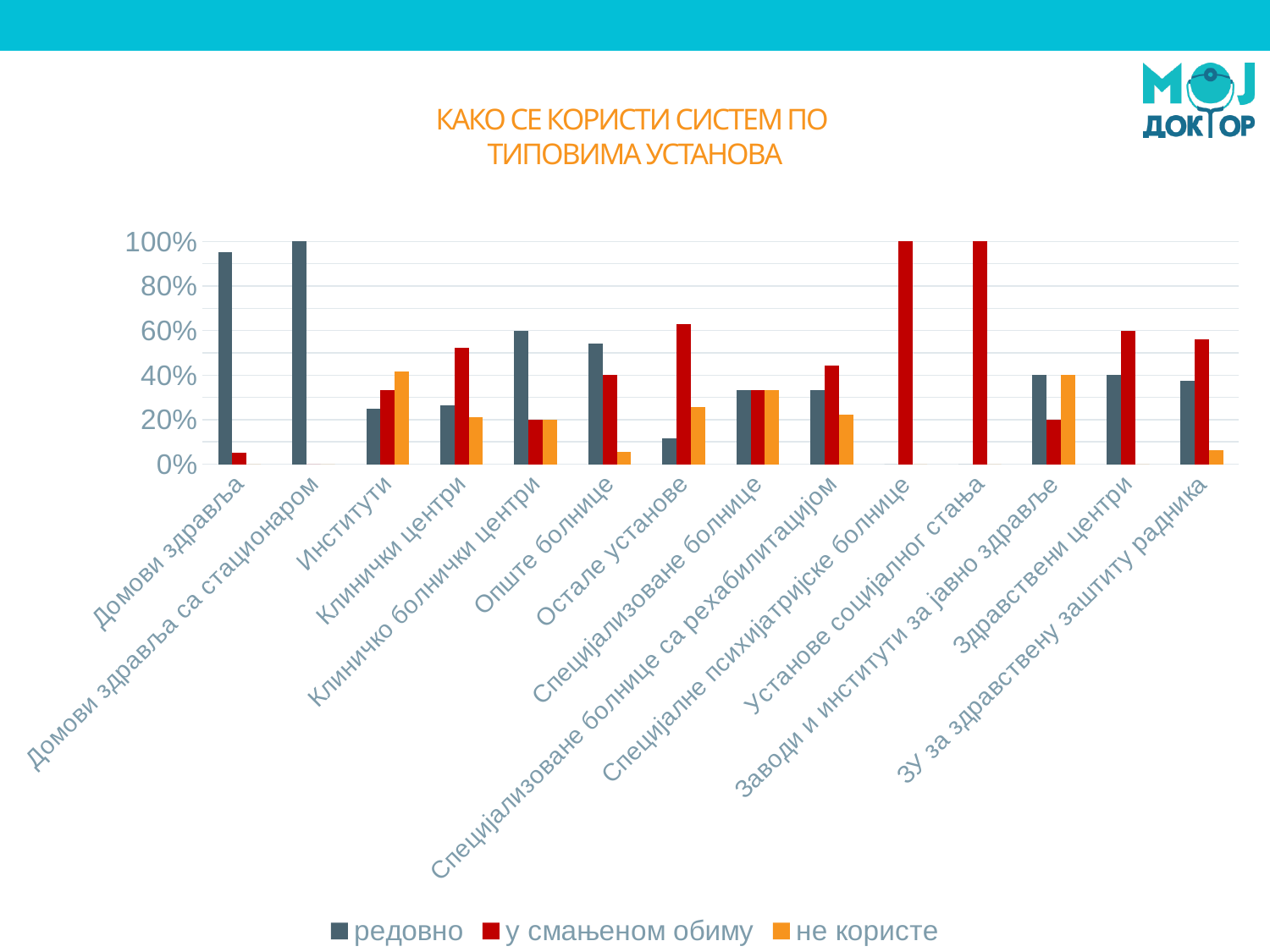
What is the value of 'у смањеном обиму' for 'Специјалне психијатријске болнице'? 100% What kind of chart is shown on the slide? bar chart For 'Институти', which is larger: 'редовно' or 'не користе'? не користе How many institution types (categories) are shown on the x axis? 14 What is the title of the chart? КАКО СЕ КОРИСТИ СИСТЕМ ПО ТИПОВИМА УСТАНОВА What is the value of 'у смањеном обиму' for 'Установе социјалног стања'? 100% What is the value of 'редовно' for 'Домови здравља са стационаром'? 100% Is the value of 'редовно' for 'Остале установе' greater or less than 20%? less Is the value of 'редовно' for 'Домови здравља' greater or less than 80%? greater How many series does the legend list? 3 For 'Опште болнице', which is larger: 'редовно' or 'у смањеном обиму'? редовно